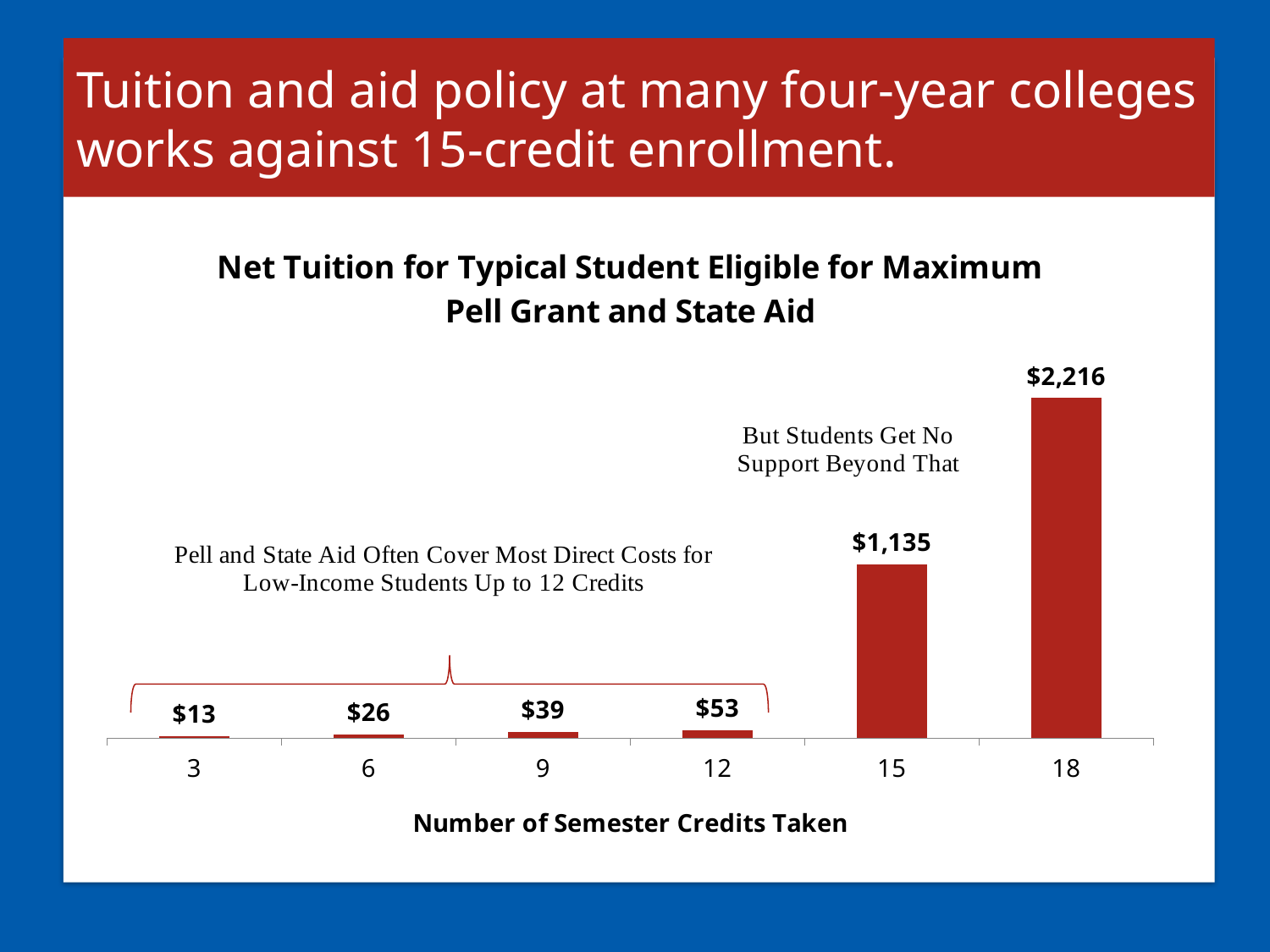
How many credit-level categories are shown on the x axis? 6 What kind of chart is shown on the slide? Bar chart What is the label of the x axis? Number of Semester Credits Taken What is the net tuition for a student taking 15 semester credits? $1,135 What is the difference in net tuition between 18 credits and 15 credits? $1,081 Which number of semester credits has the highest net tuition? 18 Which number of semester credits has the lowest net tuition? 3 What is the difference in net tuition between 15 credits and 12 credits? $1,082 What is the net tuition for a student taking 3 semester credits? $13 Which has a higher net tuition, 9 credits or 6 credits? 9 credits What is the net tuition for a student taking 18 semester credits? $2,216 What is the net tuition for a student taking 12 semester credits? $53